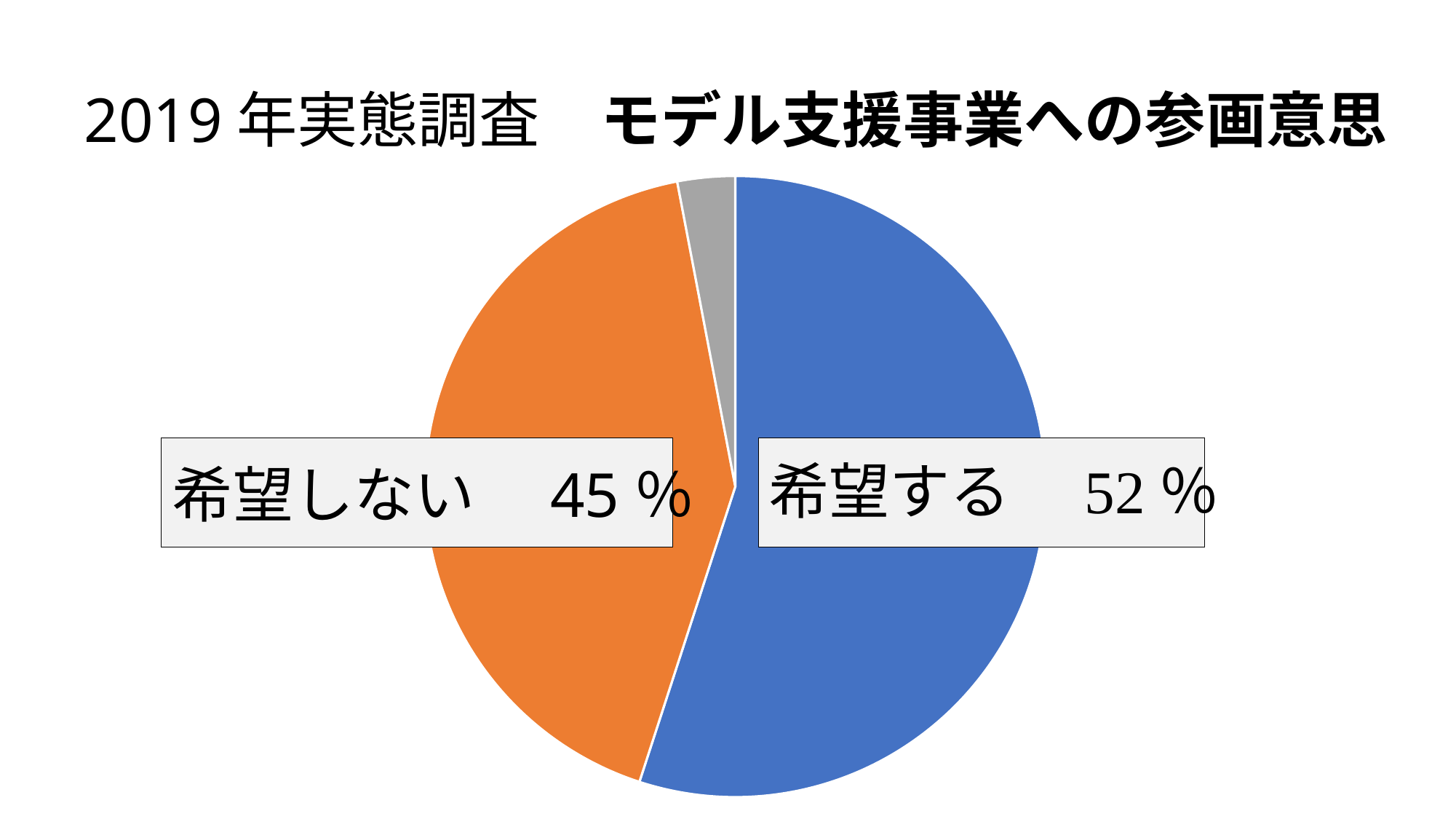
What percentage of the pie is labelled 希望する? 52% What share of the pie does the 希望する slice represent? 52% By how many percentage points does 希望する exceed 希望しない? 7 percentage points What kind of chart is shown on the slide? pie chart What colour is the 希望する slice? blue What colour is the 希望しない slice? orange How many slices does the pie chart have? 3 What percentage of the pie is labelled 希望しない? 45% Which is larger, the share for 希望する or the share for 希望しない? 希望する Which labelled category has the largest share of the pie? 希望する